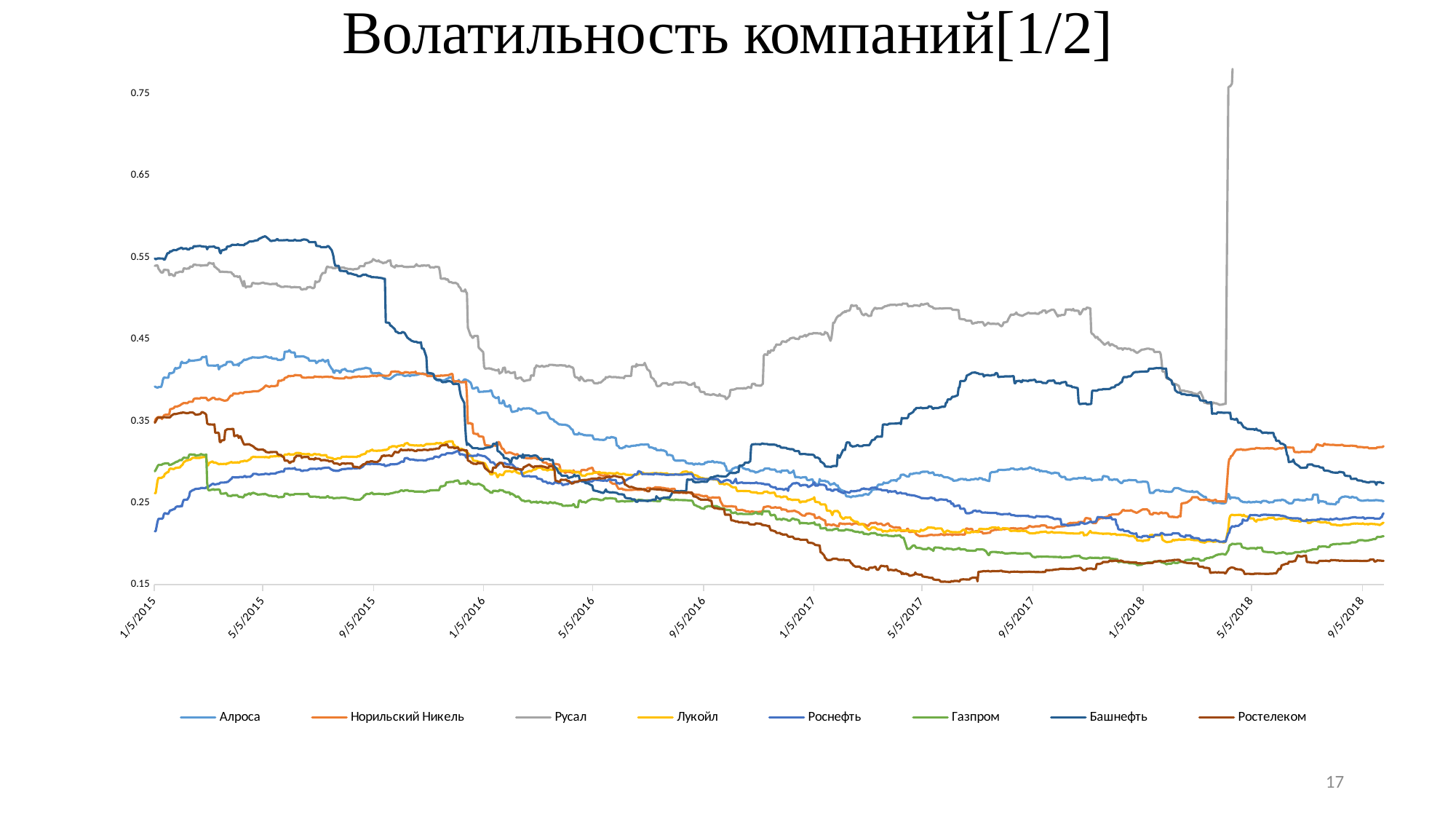
What is the title of the chart? Волатильность компаний[1/2] At 1/5/2015, which series is higher, Алроса or Газпром? Алроса Which series has the lowest value at 9/5/2018? Ростелеком Is the value for Русал at 5/5/2017 greater or less than 0.45? greater At 9/5/2018, which series is higher, Норильский Никель or Газпром? Норильский Никель Does the Алроса line rise or fall overall from 1/5/2015 to 9/5/2018? fall What kind of chart is shown on the slide? Line chart Does the Башнефть line rise or fall from 1/5/2015 to 5/5/2016? fall How many series does the legend list? 8 Which series reaches the highest value anywhere on the chart? Русал Is the value for Башнефть at 1/5/2015 greater or less than 0.45? greater Is the value for Ростелеком at 9/5/2018 greater or less than 0.25? less